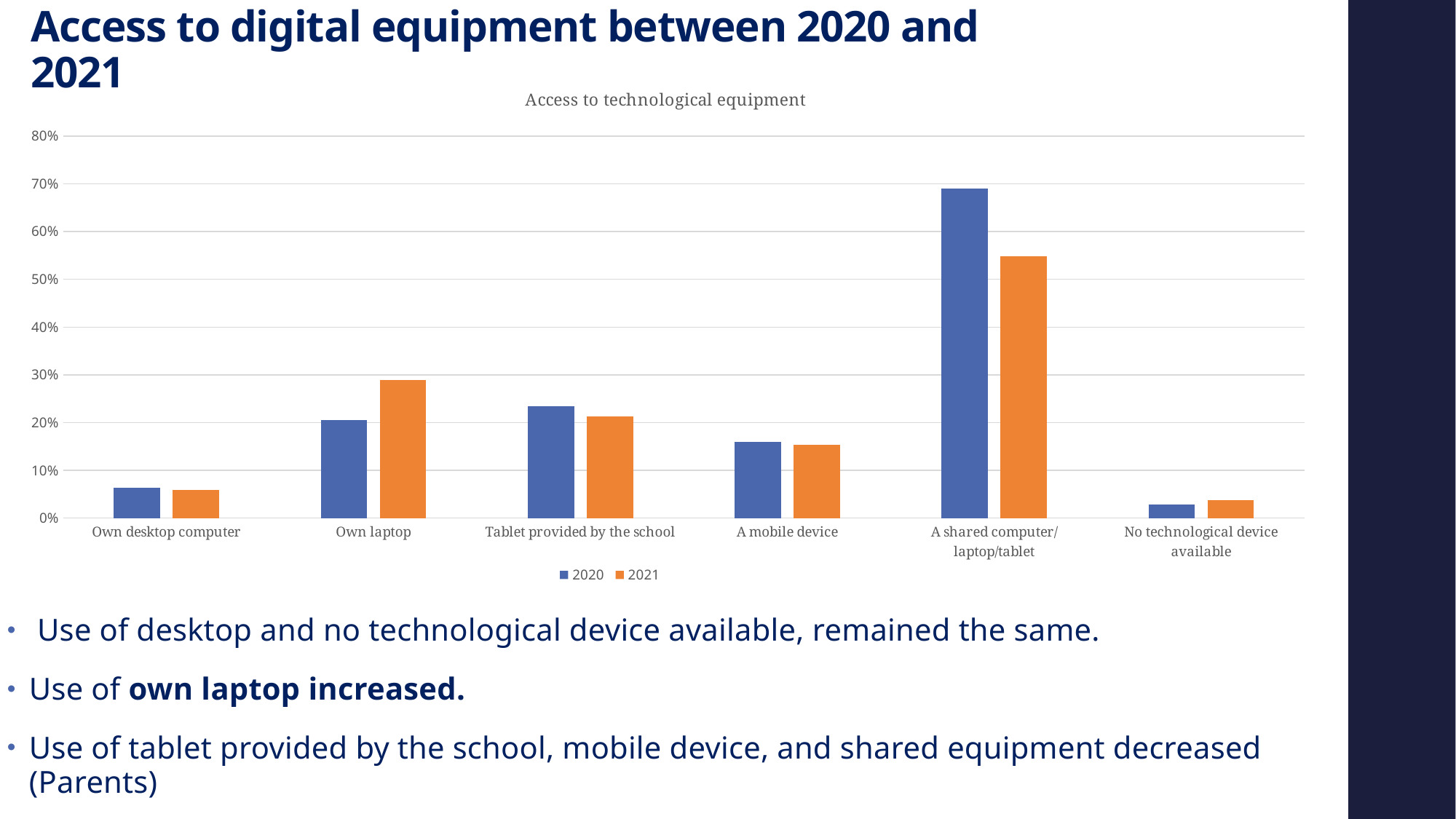
What kind of chart is shown on the slide? Bar chart Is the 2020 value for A shared computer/laptop/tablet greater or less than 60%? greater What is the title of the chart? Access to technological equipment Which category has the highest value for 2020? A shared computer/laptop/tablet How many categories are shown on the x axis of the chart? 6 Which category has the highest value for 2021? A shared computer/laptop/tablet Is the 2020 value for A mobile device greater or less than 20%? less How many series does the chart's legend list? 2 For A shared computer/laptop/tablet, which year has the larger value, 2020 or 2021? 2020 Which category has the lowest value for 2020? No technological device available For Own laptop, which year has the larger value, 2020 or 2021? 2021